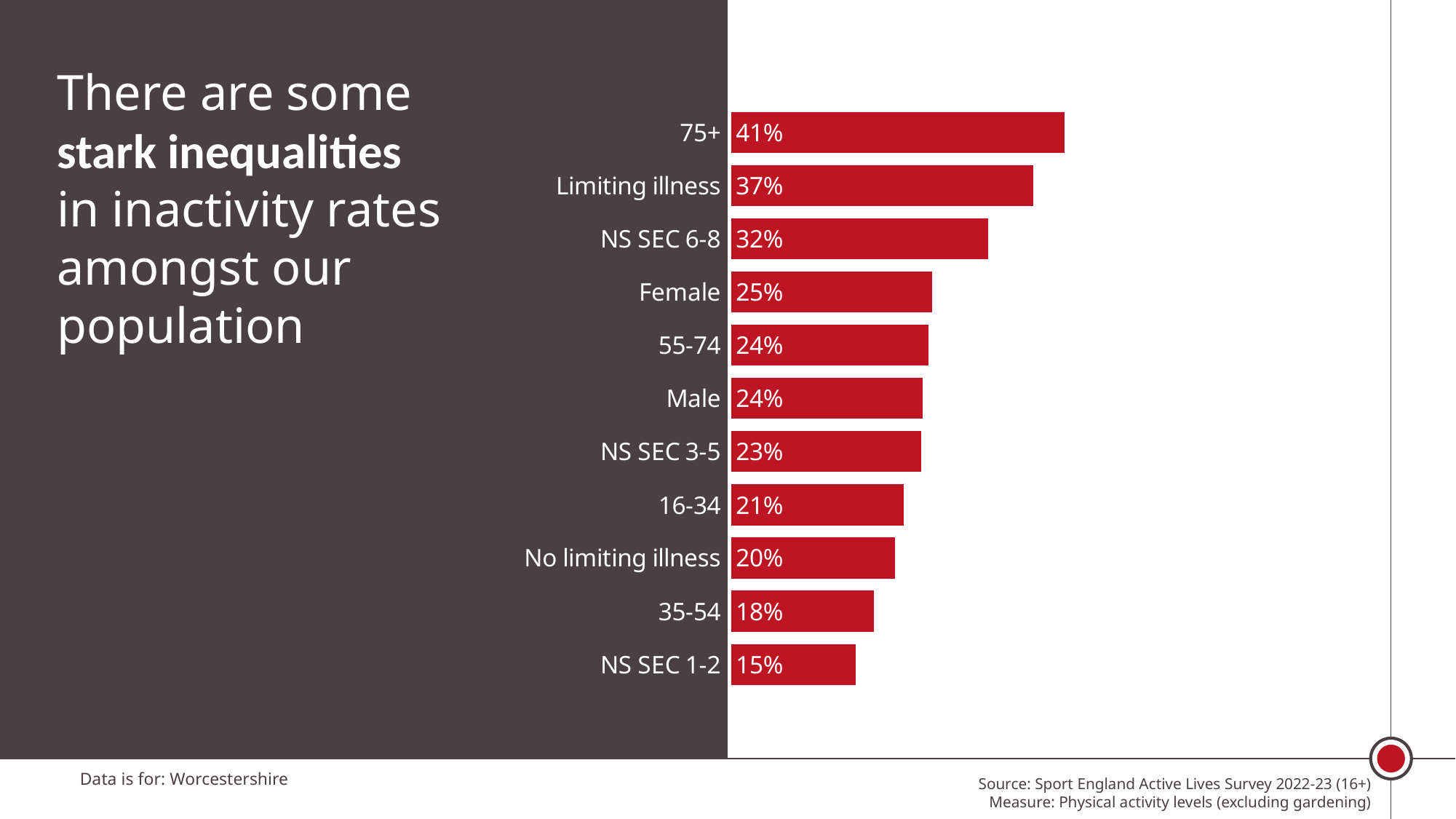
What is the inactivity rate for people with a limiting illness? 37% What is the inactivity rate for the 35-54 age group? 18% What is the difference in inactivity rate between the 75+ group and NS SEC 1-2? 26% Which category has the highest inactivity rate? 75+ Which has a higher inactivity rate, NS SEC 6-8 or NS SEC 3-5? NS SEC 6-8 What is the inactivity rate for NS SEC 1-2? 15% What is the inactivity rate for the 75+ group? 41% Which has a higher inactivity rate, Female or Male? Female How many categories are shown in the chart? 11 Which category has the lowest inactivity rate? NS SEC 1-2 What kind of chart is shown on the slide? Bar chart What is the difference in inactivity rate between Limiting illness and No limiting illness? 17%